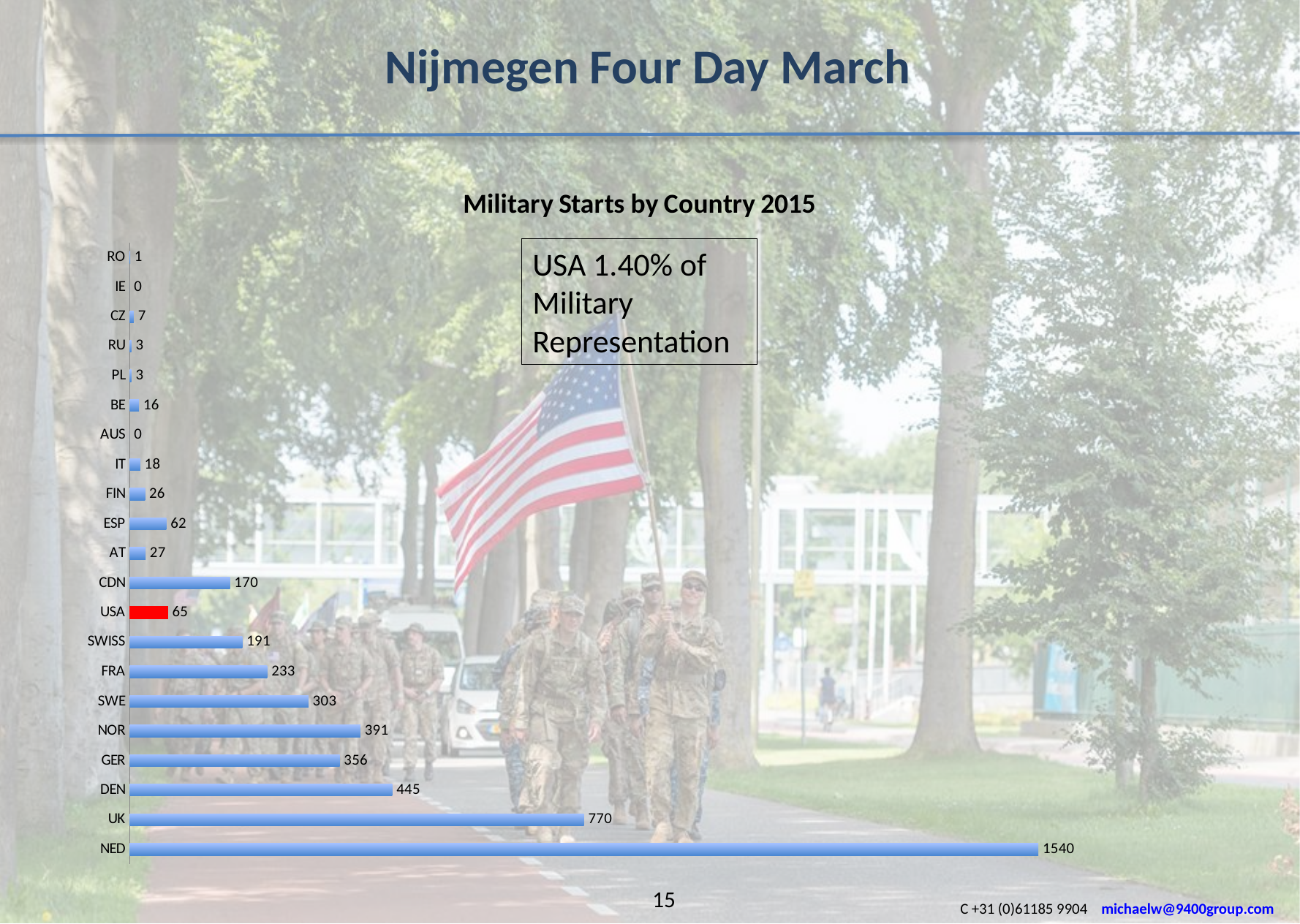
What type of chart is used to show Military Starts by Country 2015? Bar chart According to the text box on the chart, what percentage of military representation is the USA? 1.40% What is the difference between the values for NED and UK? 770 What is the value for NED in the Military Starts by Country 2015 chart? 1540 Which bar in the chart is coloured red? USA How many military starts does the chart show for USA? 65 How many countries are listed in the chart? 21 Which country has the highest number of military starts in the chart? NED What is the difference between the values for UK and DEN? 325 What is the value shown for DEN? 445 Which has a larger value, CDN or USA? CDN Which has a larger value, NOR or GER? NOR